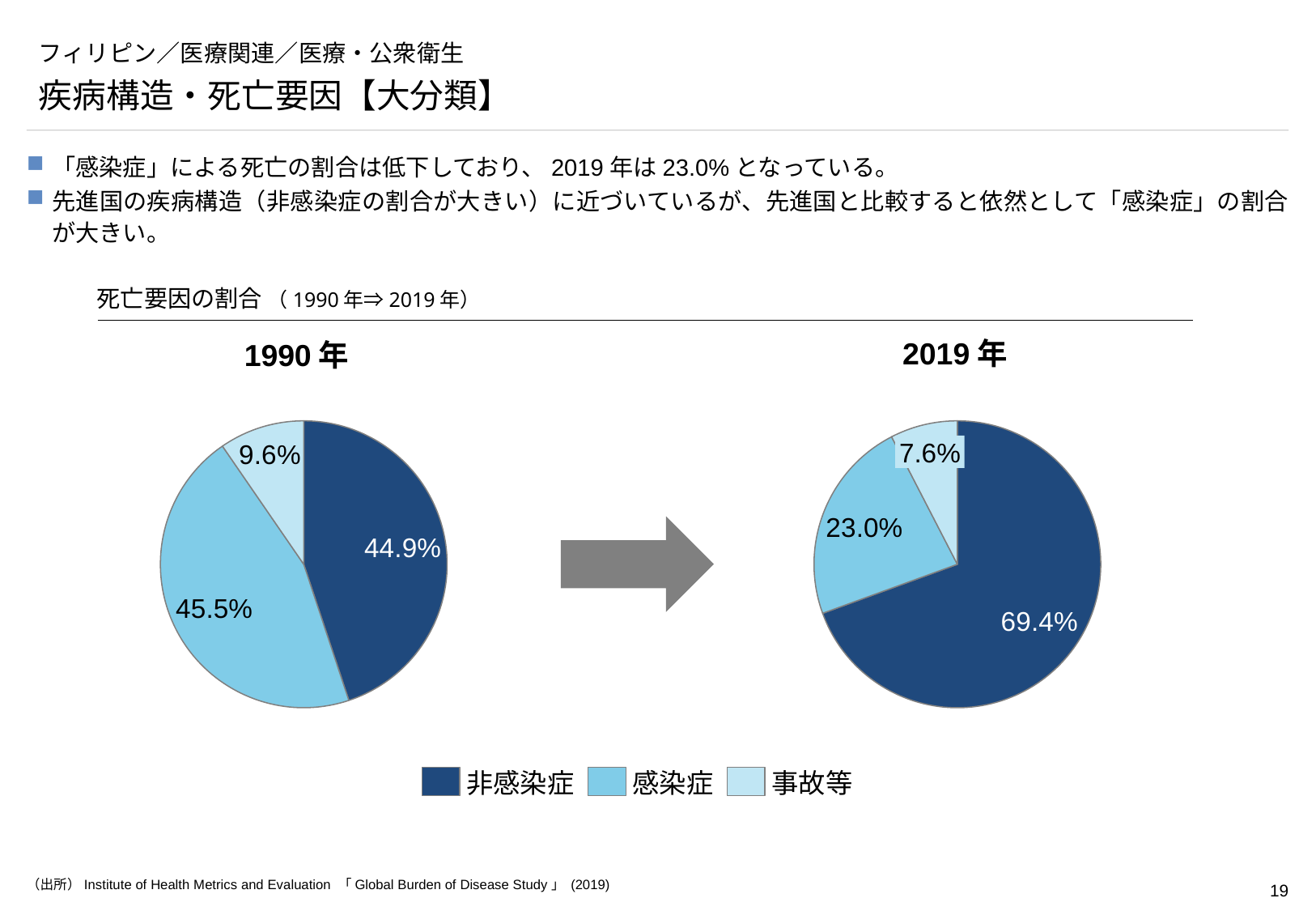
In the 1990年 pie chart, which category has the largest share? 感染症 In the 1990年 pie chart, what is the share for 感染症? 45.5% In the 2019年 pie chart, what is the share for 事故等? 7.6% In the 2019年 pie chart, what is the share for 非感染症? 69.4% Is the 事故等 share larger in the 1990年 pie chart or the 2019年 pie chart? 1990年 In the 2019年 pie chart, what is the difference between the 非感染症 share and the 感染症 share? 46.4% How many categories does each pie chart show? 3 In the 2019年 pie chart, which category has the smallest share? 事故等 What type of chart is used to show the 死亡要因の割合 for 1990年 and 2019年? Pie chart In the 1990年 pie chart, what is the share for 非感染症? 44.9% What is the difference between the 感染症 share in the 1990年 pie chart and in the 2019年 pie chart? 22.5% Which category is shown in the darkest blue in the legend? 非感染症